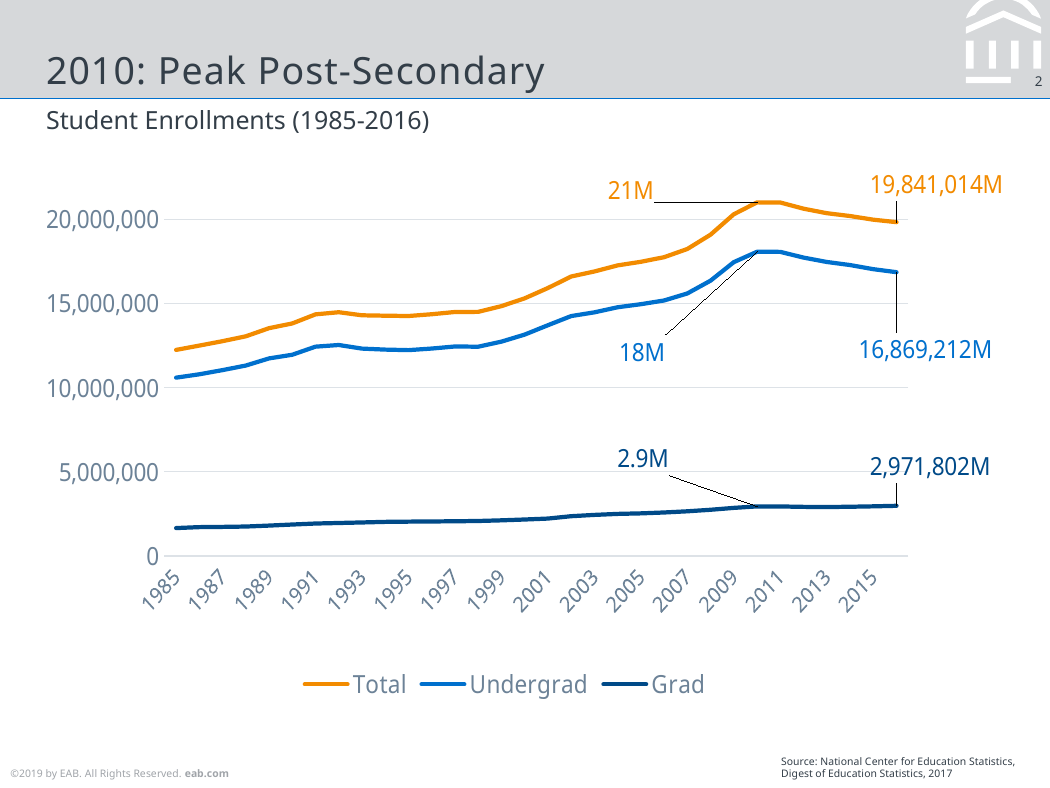
What is the labelled value of the Undergrad series at the right end of the chart (2016)? 16,869,212M What label marks the peak of the Total series around 2010? 21M What is the title of the chart? Student Enrollments (1985-2016) Is the value of the Total series in 1985 greater or less than 15,000,000? less What is the labelled value of the Total series at the right end of the chart (2016)? 19,841,014M What is the labelled value of the Grad series at the right end of the chart (2016)? 2,971,802M What label marks the peak of the Undergrad series around 2010? 18M What kind of chart is shown on the slide? line chart What is the difference between the 2016 Total value and the 2016 Undergrad value? 2,971,802M Which series has the lowest values across the whole chart? Grad How many series does the legend list? 3 Does the Total series rise or fall between 1985 and 2010? rise